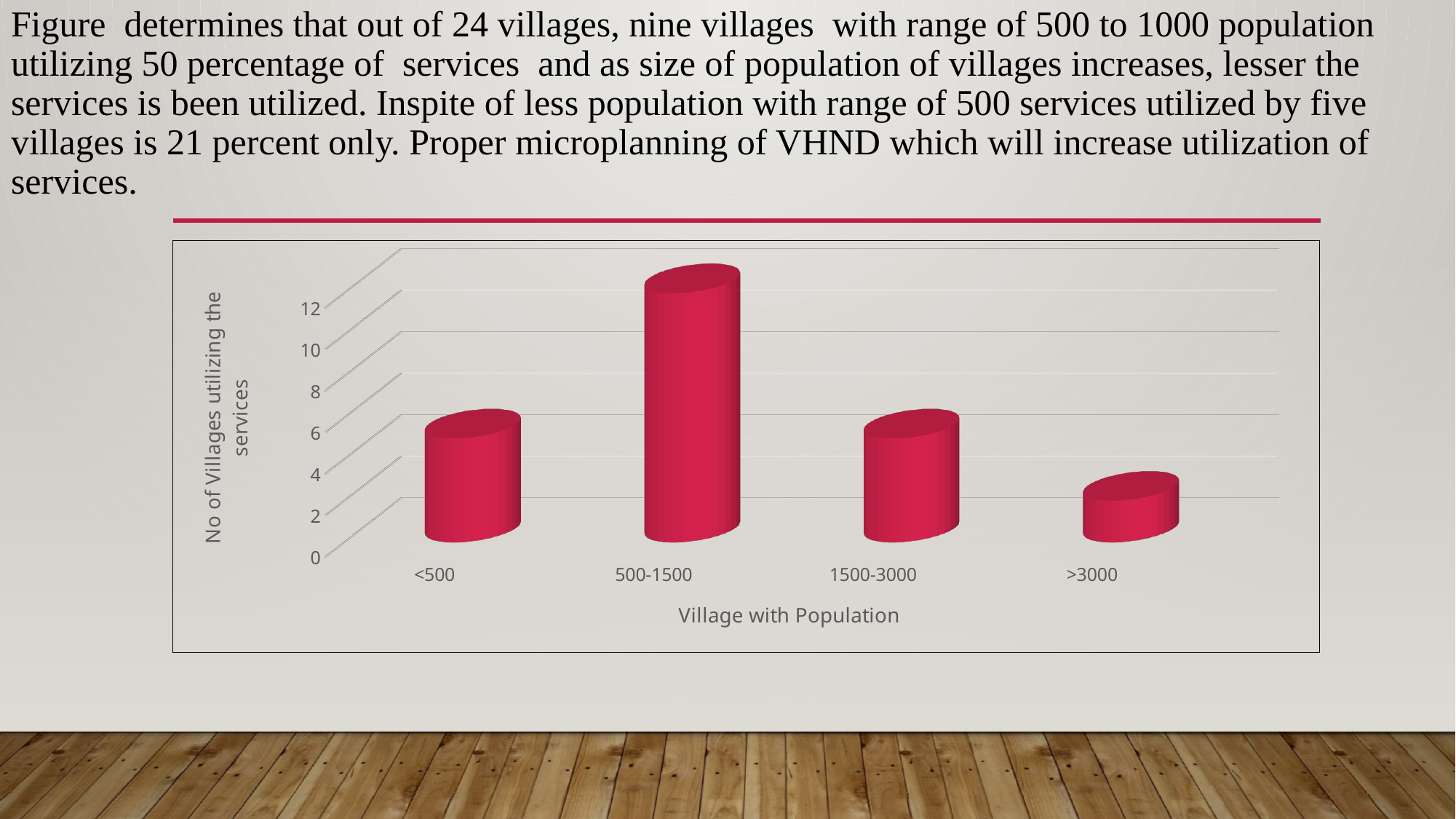
Is the value for 500-1500 greater or less than 10? greater What kind of chart is shown on the slide? bar chart Which population category has the lowest number of villages utilizing the services? >3000 Which population category has the highest number of villages utilizing the services? 500-1500 Is the value for >3000 greater or less than 4? less Which has more villages utilizing the services: 500-1500 or >3000? 500-1500 What is the title of the x axis of the chart? Village with Population How many population categories are shown on the x axis of the chart? 4 Moving from 500-1500 to >3000 along the x axis, do the values rise or fall? fall Is the value for 1500-3000 greater or less than 2? greater Which has more villages utilizing the services: 500-1500 or <500? 500-1500